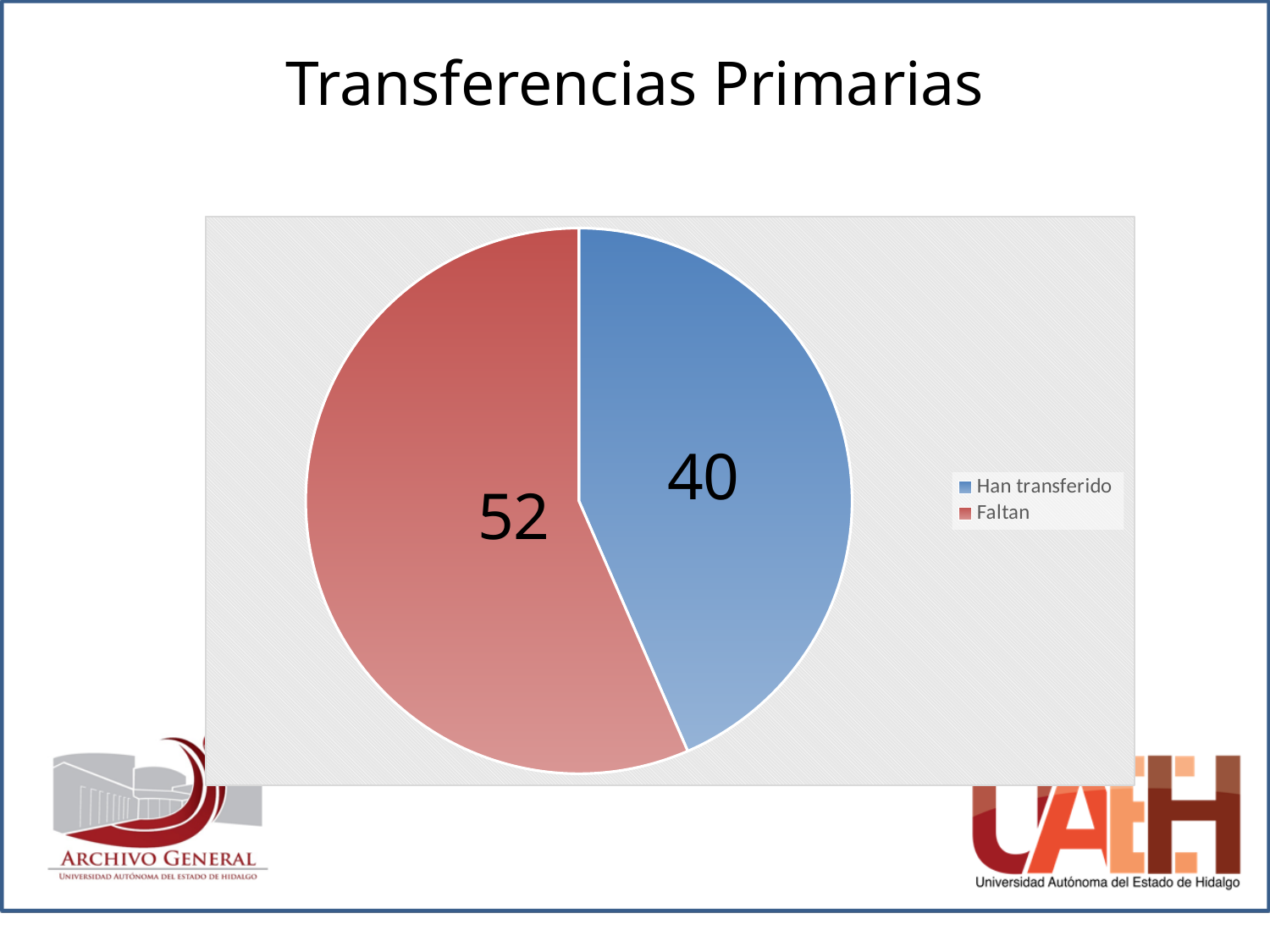
What is the title of the slide containing the chart? Transferencias Primarias What is the total of the two slices in the pie chart? 92 Which category has the largest slice of the pie? Faltan What kind of chart is shown on the slide? Pie chart Which is larger, the value for "Han transferido" or the value for "Faltan"? Faltan How many entries does the legend list? 2 How many slices does the pie chart have? 2 What is the difference between the values for "Faltan" and "Han transferido"? 12 Which category has the smallest slice of the pie? Han transferido What is the value for "Han transferido"? 40 What colour is the "Faltan" slice? Red What is the value for "Faltan"? 52